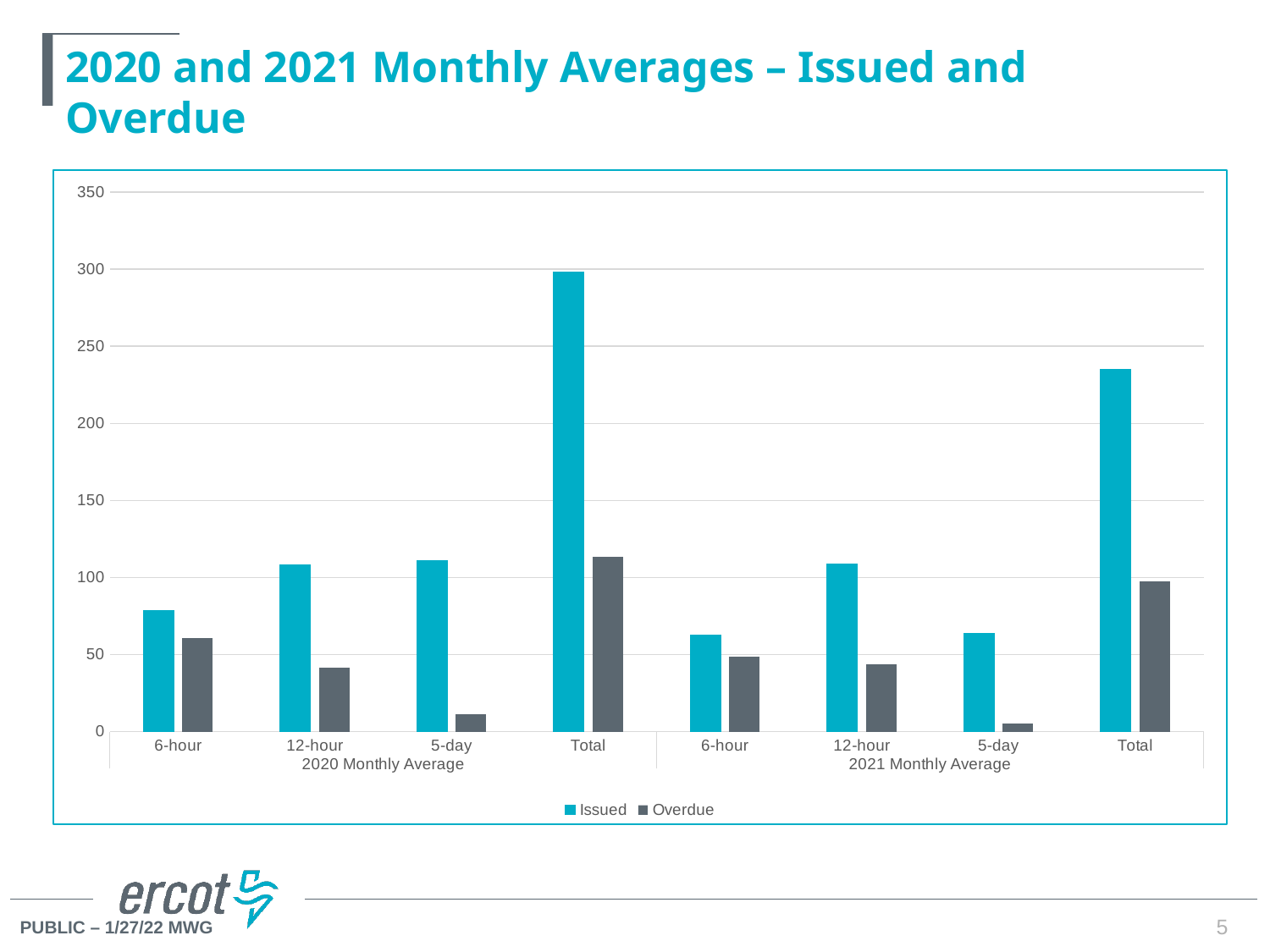
Which category has the highest Issued bar? Total (2020 Monthly Average) Which is larger: the Overdue value for Total in 2020 Monthly Average or the Overdue value for Total in 2021 Monthly Average? Total in 2020 Monthly Average Is the Issued value for 12-hour in the 2021 Monthly Average group greater or less than 100? greater How many categories are shown along the x axis in total across both groups? 8 What are the two series named in the legend? Issued and Overdue Which category has the lowest Overdue bar? 5-day (2021 Monthly Average) What kind of chart is shown on the slide? Bar chart How many series does the legend list? 2 Is the Overdue value for 5-day in the 2020 Monthly Average group greater or less than 50? less Is the Issued value for Total in the 2021 Monthly Average group greater or less than 250? less Which is larger: the Issued value for 6-hour in 2020 Monthly Average or the Issued value for 6-hour in 2021 Monthly Average? 6-hour in 2020 Monthly Average